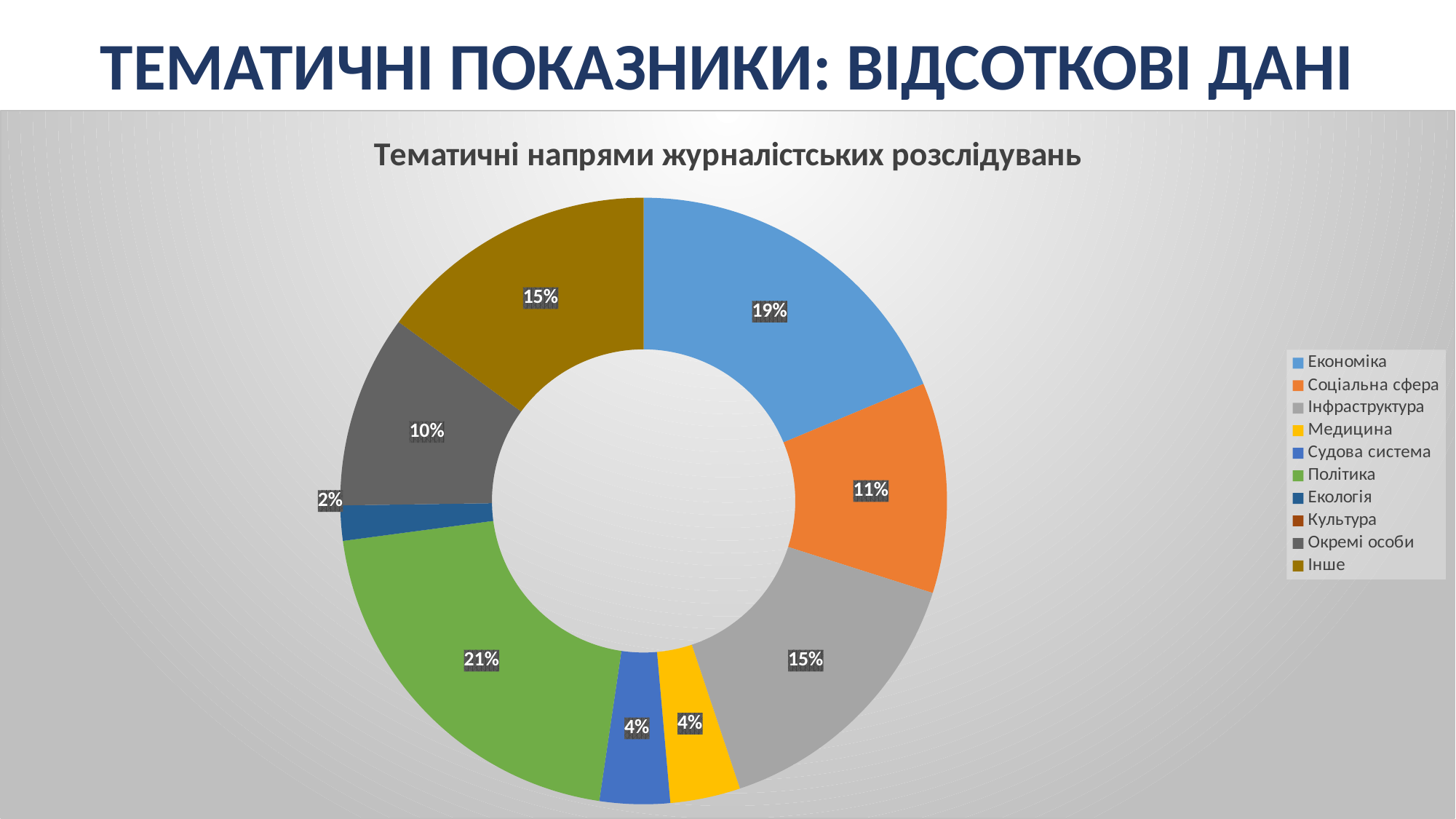
Which is larger, the share for Економіка or the share for Інфраструктура? Економіка What percentage is shown for Соціальна сфера? 11% What percentage is shown for Екологія? 2% What percentage is shown for Окремі особи? 10% What is the title of the chart? Тематичні напрями журналістських розслідувань What is the difference in percentage points between Політика and Економіка? 2 What percentage is shown for Політика? 21% How many entries does the chart legend list? 10 What is the difference in percentage points between Інфраструктура and Медицина? 11 What percentage is shown for Економіка? 19% What type of chart is shown on the slide? Doughnut (pie) chart Which category has the largest share of the chart? Політика